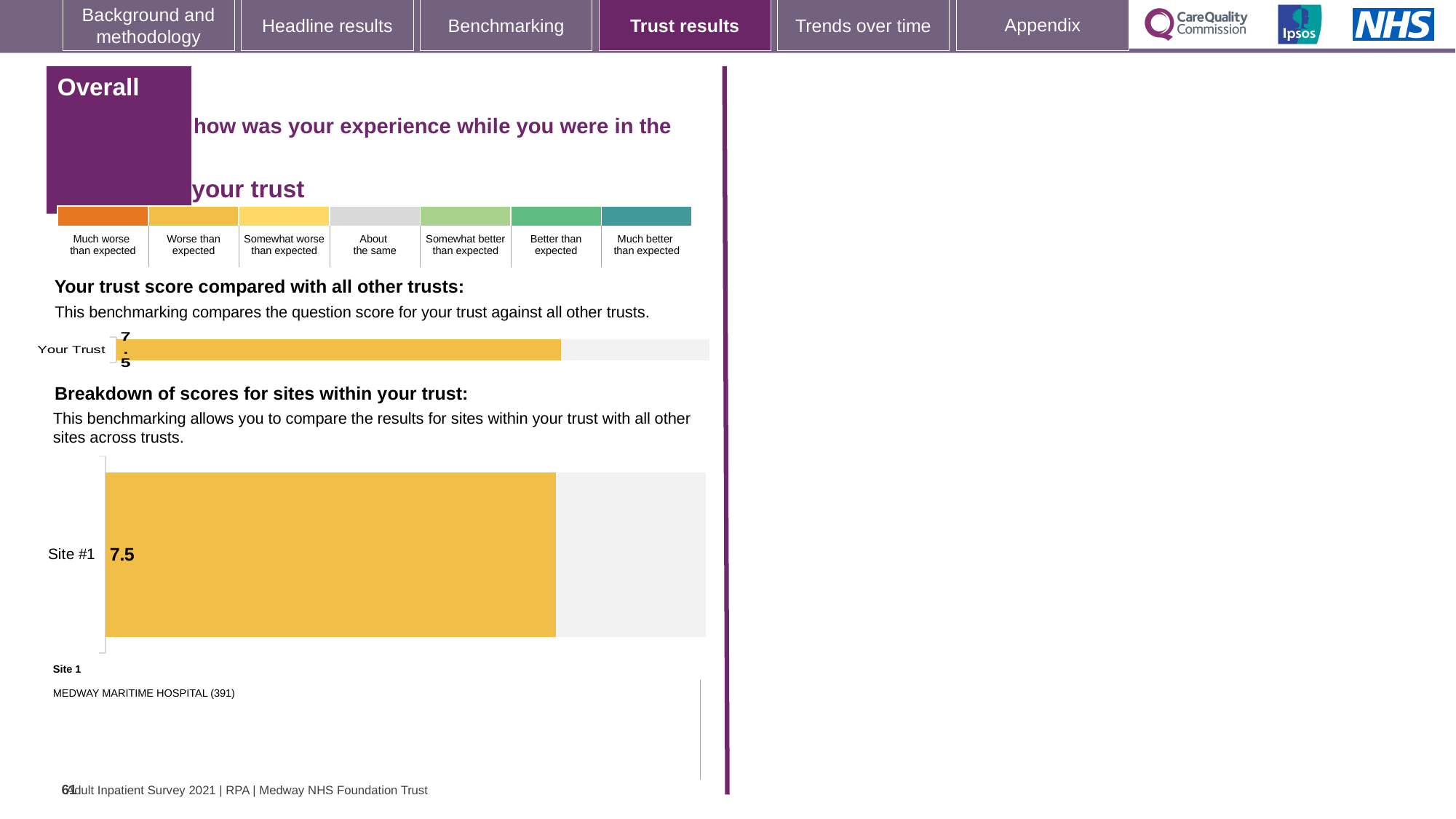
In the 'Breakdown of scores for sites within your trust' chart, what is the value for Site #1? 7.5 What kind of chart is the 'Your trust score compared with all other trusts' chart? bar chart What kind of chart is the 'Breakdown of scores for sites within your trust' chart? bar chart In the 'Your trust score compared with all other trusts' chart, what is the value for Your Trust? 7.5 What is the difference between the Your Trust value in the top chart and the Site #1 value in the bottom chart? 0.0 Which site name is listed under 'Site 1' below the bottom chart? MEDWAY MARITIME HOSPITAL (391) Is the Your Trust value in the top chart larger than, smaller than, or equal to the Site #1 value in the bottom chart? equal What is the category label of the single bar in the 'Breakdown of scores for sites within your trust' chart? Site #1 How many bars are plotted in the 'Your trust score compared with all other trusts' chart? 1 How many bars are plotted in the 'Breakdown of scores for sites within your trust' chart? 1